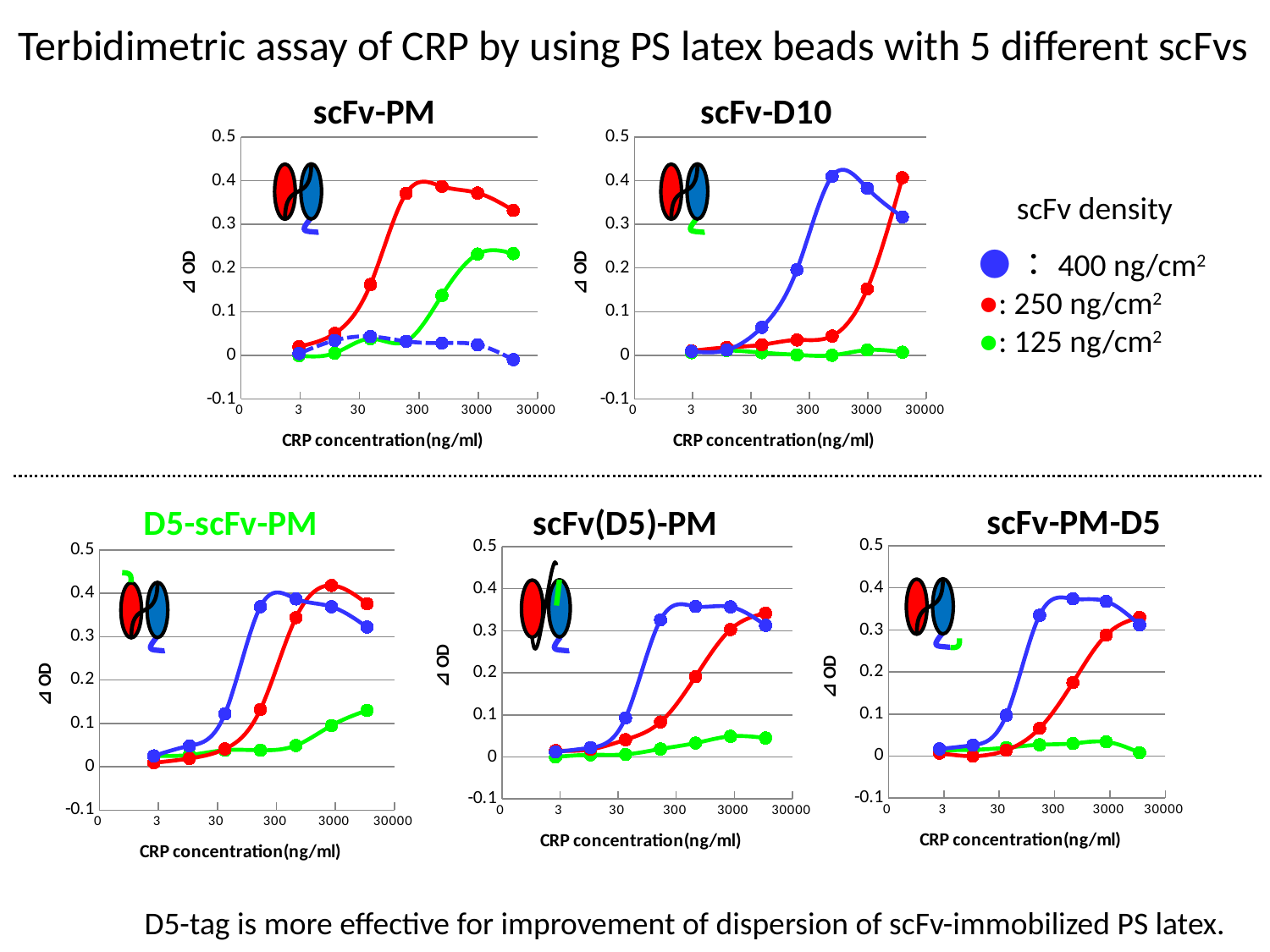
How many charts are shown on the slide? 5 In the scFv-PM chart, which series reaches the highest ΔOD? 250 ng/cm² How many scFv density series does the legend list? 3 In the scFv-D10 chart, is the ΔOD value for the 125 ng/cm² series at 30000 ng/ml CRP greater or less than 0.1? less What kind of chart is the scFv-PM chart? line chart In the scFv-PM-D5 chart, does the ΔOD of the 400 ng/cm² series rise or fall as CRP concentration increases from 3 to 300 ng/ml? rise According to the legend, which colour represents the 400 ng/cm² scFv density? blue In the scFv(D5)-PM chart, is the ΔOD value for the 400 ng/cm² series at 1000 ng/ml CRP greater or less than 0.3? greater In the scFv-D10 chart, which series stays lowest across the CRP concentrations? 125 ng/cm² In the scFv-PM chart, is the ΔOD value for the 250 ng/cm² series at 300 ng/ml CRP greater or less than 0.3? greater In the scFv-D10 chart, at 300 ng/ml CRP, which series has the larger ΔOD: 400 ng/cm² or 250 ng/cm²? 400 ng/cm² What is the x-axis label on the D5-scFv-PM chart? CRP concentration(ng/ml)